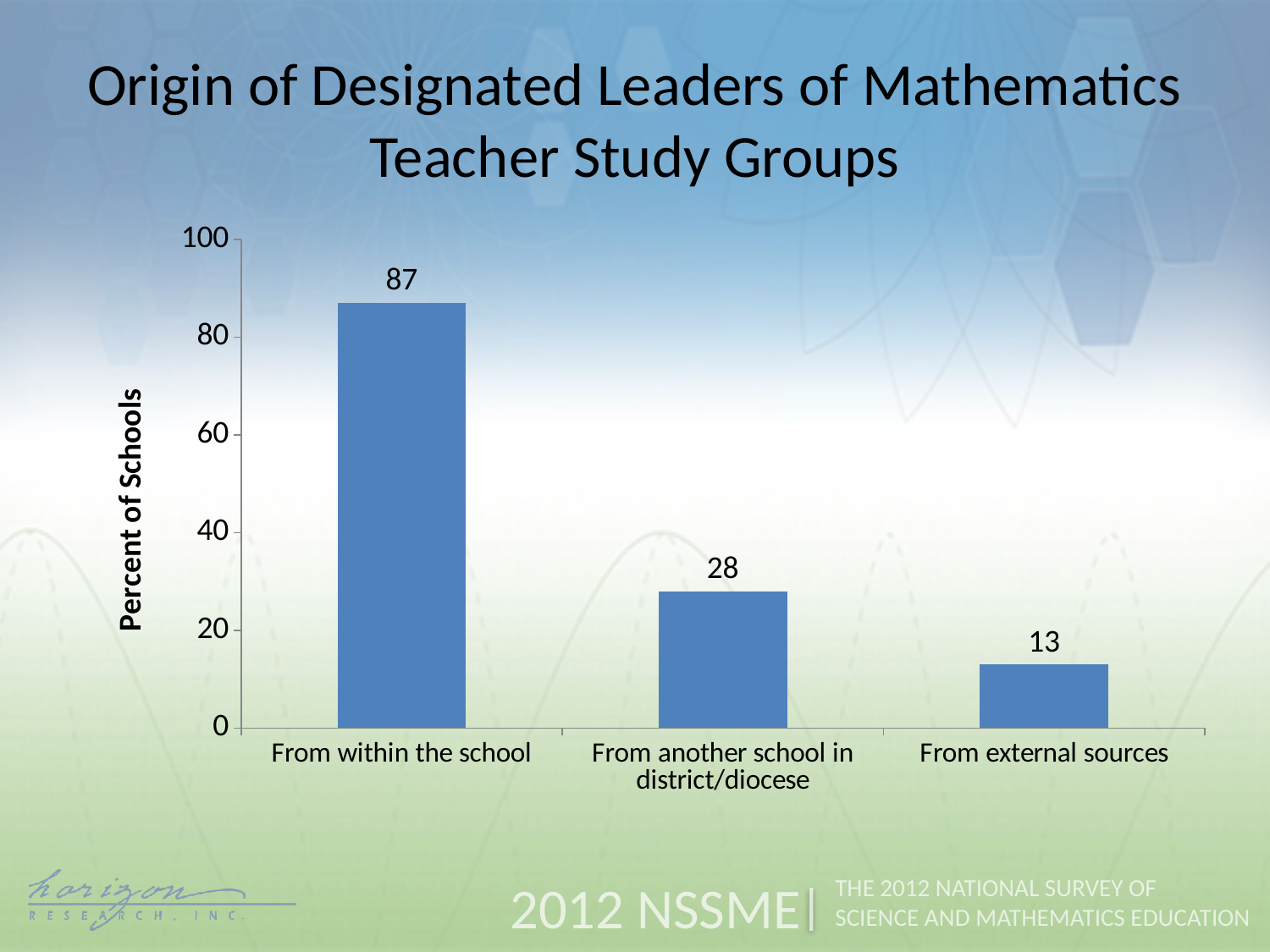
What is the difference between the values for "From within the school" and "From another school in district/diocese"? 59 What is the label of the y axis? Percent of Schools Which category has the lowest value? From external sources How many categories are shown on the x axis? 3 Which category has the highest value? From within the school What is the value for "From another school in district/diocese"? 28 What is the value for "From within the school"? 87 What is the difference between the values for "From another school in district/diocese" and "From external sources"? 15 Is the value for "From within the school" greater or less than 80? greater What is the value for "From external sources"? 13 Which is larger: the value for "From another school in district/diocese" or "From external sources"? From another school in district/diocese What kind of chart is shown on the slide? Bar chart